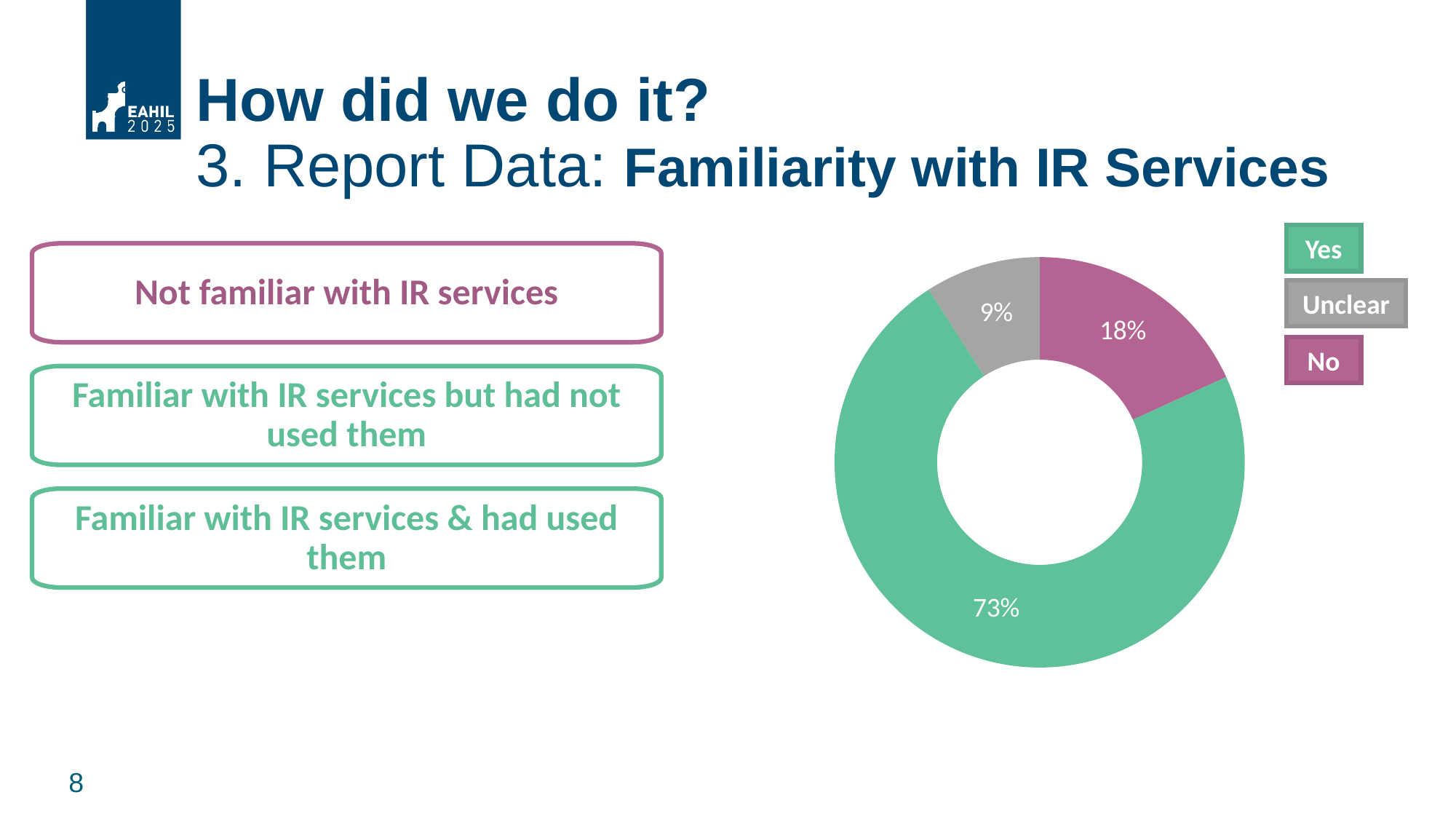
What is the difference in percentage points between the Yes and No shares? 55 What colour represents the Unclear category in the chart? Grey What kind of chart is shown on the slide? Doughnut (pie) chart Which is larger, the share for No or the share for Unclear? No What share of the doughnut chart is labelled No? 18% Which category has the largest share of the doughnut chart? Yes What colour represents the Yes category in the chart? Green What share of the doughnut chart is labelled Unclear? 9% What is the difference in percentage points between the No and Unclear shares? 9 What share of the doughnut chart is labelled Yes? 73% How many categories does the doughnut chart show? 3 Which category has the smallest share of the doughnut chart? Unclear